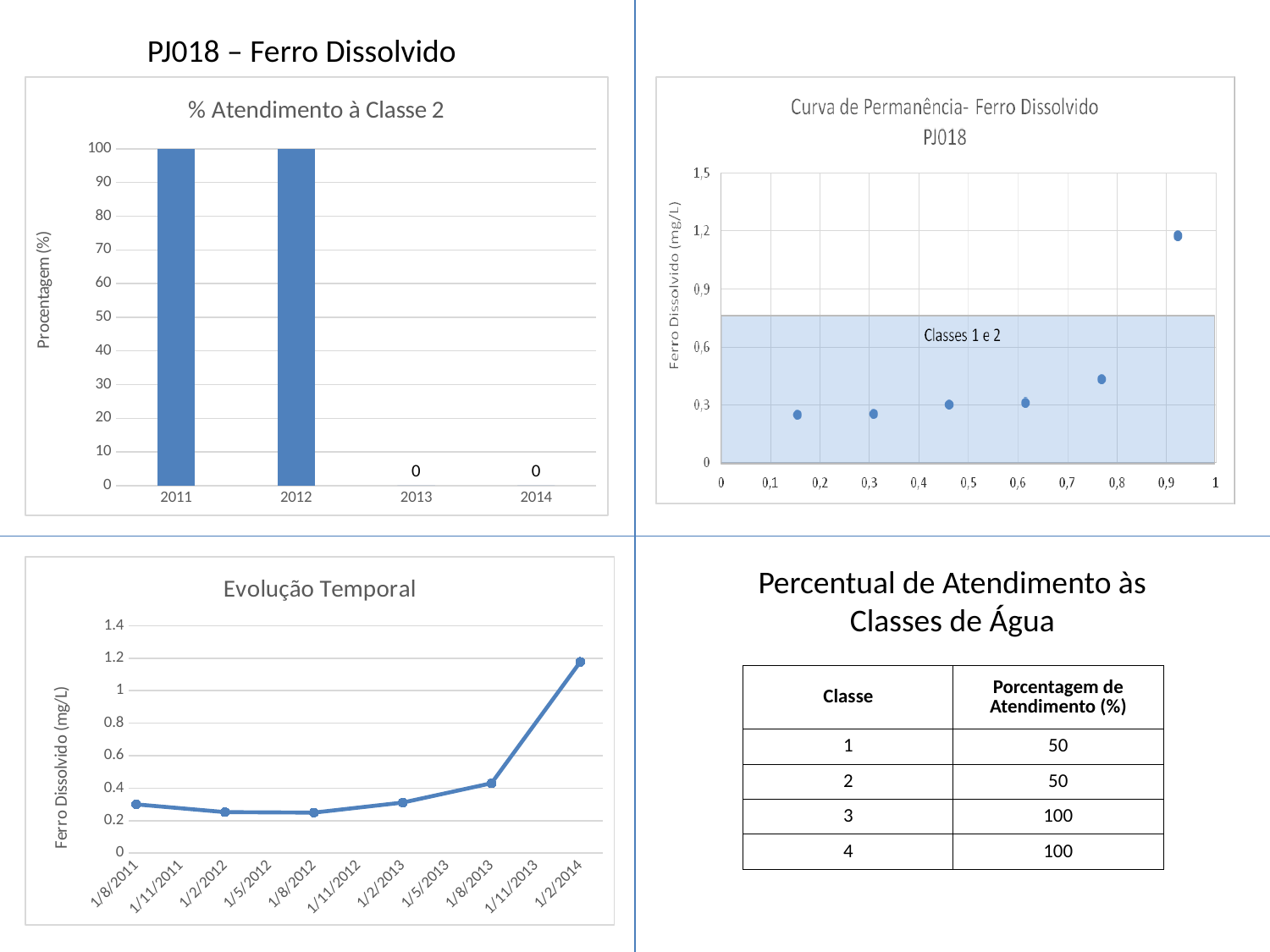
In the 'Curva de Permanência - Ferro Dissolvido PJ018' chart, how many data points are plotted? 6 In the '% Atendimento à Classe 2' chart, what is the difference between the values for 2012 and 2013? 100 In the 'Evolução Temporal' chart, is the value for 1/2/2014 greater or less than 1? greater In the 'Curva de Permanência - Ferro Dissolvido PJ018' chart, is the value of the highest point greater or less than 0.9? greater What is the y-axis label of the 'Evolução Temporal' chart? Ferro Dissolvido (mg/L) In the '% Atendimento à Classe 2' chart, what is the value for 2011? 100 In the 'Evolução Temporal' chart, is the value for 1/8/2011 greater or less than 0.6? less What kind of chart is '% Atendimento à Classe 2'? bar chart In the '% Atendimento à Classe 2' chart, which is larger, the value for 2012 or the value for 2014? 2012 In the '% Atendimento à Classe 2' chart, what is the value for 2013? 0 In the '% Atendimento à Classe 2' chart, what is the value for 2014? 0 In the '% Atendimento à Classe 2' chart, how many years are shown on the x axis? 4